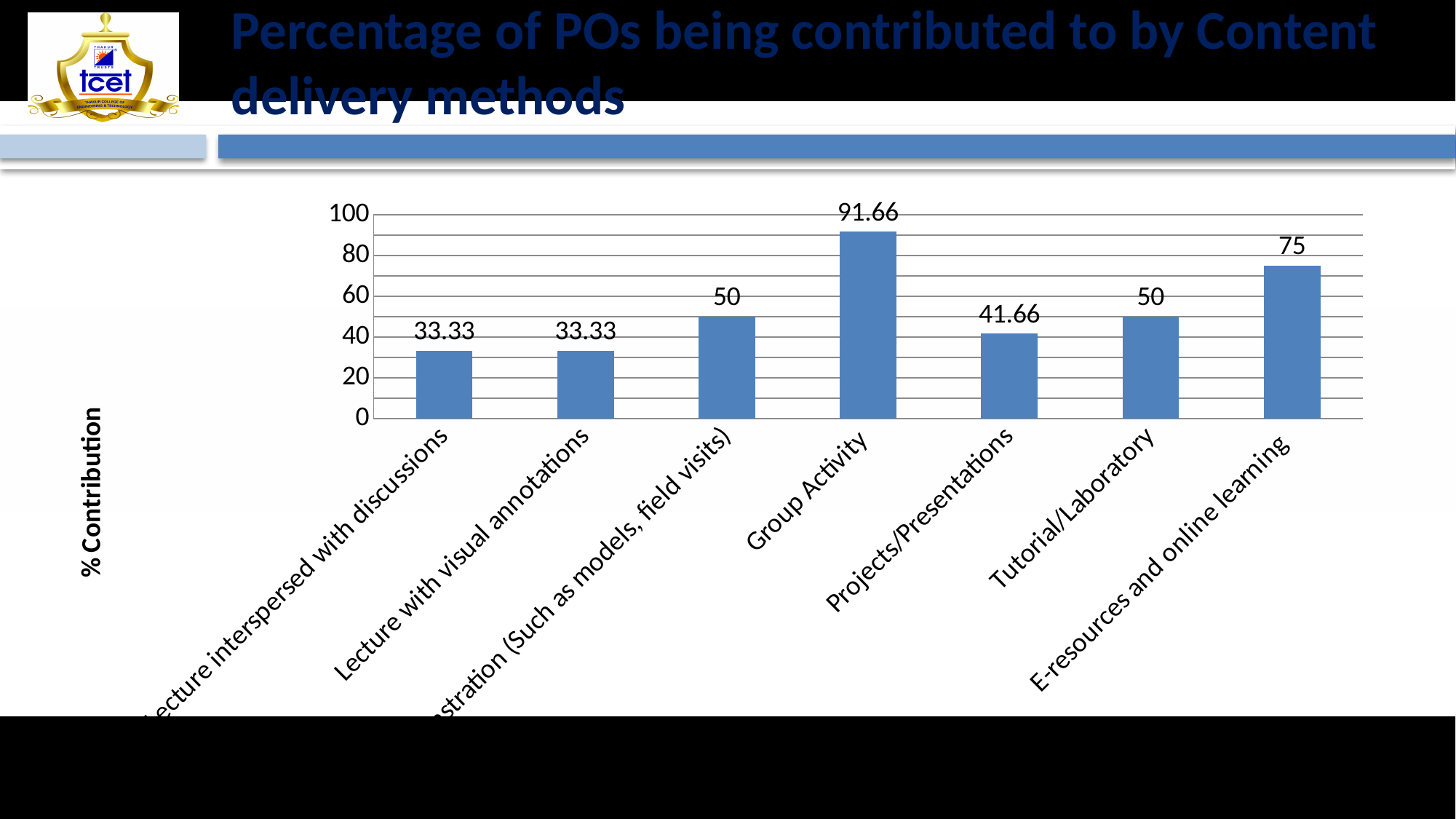
What is the label on the vertical axis of the chart? % Contribution Which category has the highest value? Group Activity How many categories are shown in the chart? 7 What is the value for Projects/Presentations? 41.66 What kind of chart is shown on the slide? Bar chart What is the value for Group Activity? 91.66 What is the value for Tutorial/Laboratory? 50 What is the title of the slide? Percentage of POs being contributed to by Content delivery methods What is the difference between the values for Group Activity and E-resources and online learning? 16.66 What is the value for E-resources and online learning? 75 Which is larger, the value for Projects/Presentations or the value for Tutorial/Laboratory? Tutorial/Laboratory What is the value for Lecture with visual annotations? 33.33